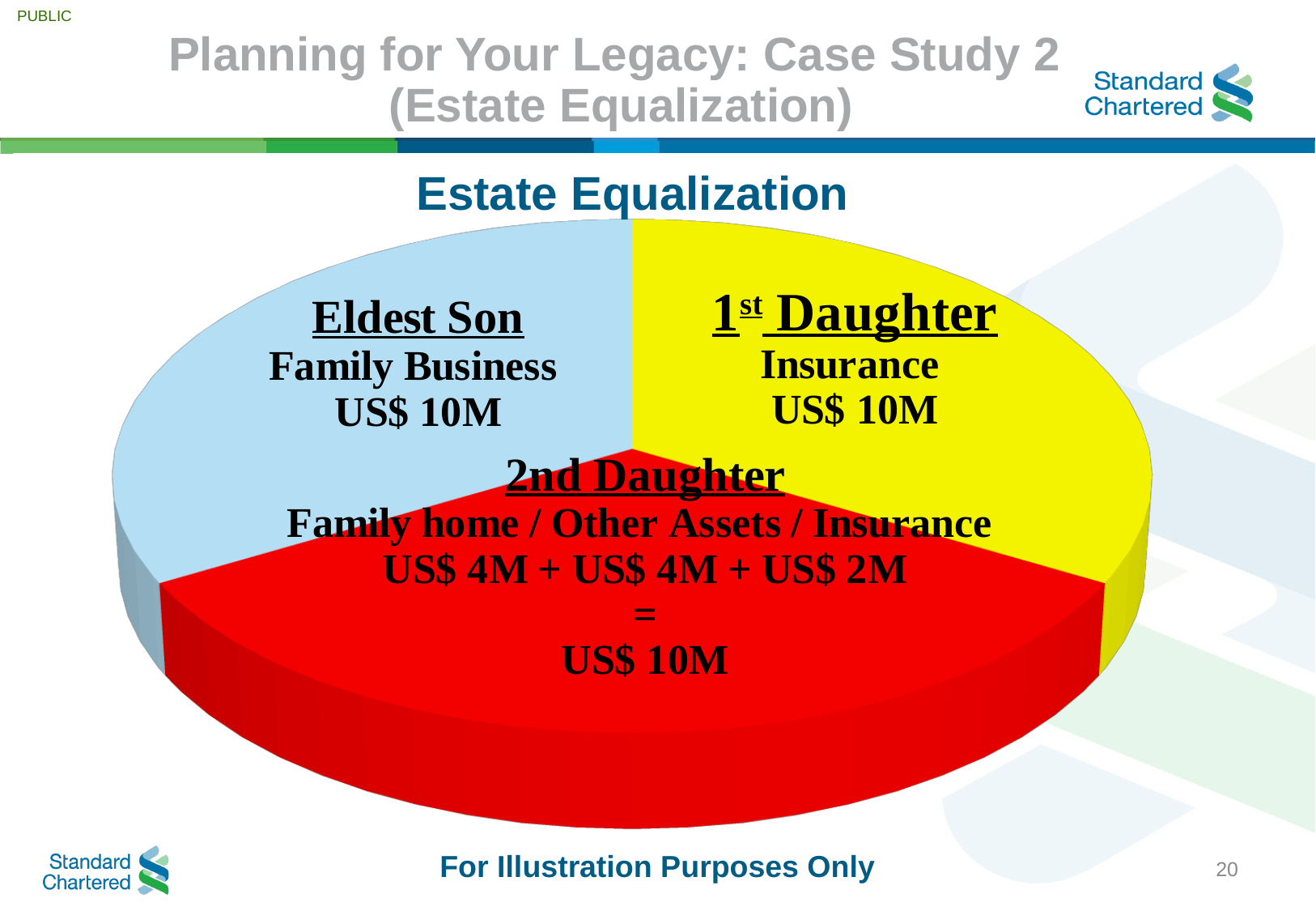
What is the title of the pie chart? Estate Equalization What three amounts make up the 2nd Daughter's US$ 10M share? US$ 4M + US$ 4M + US$ 2M Is the Eldest Son's share larger than, smaller than, or equal to the 1st Daughter's share? Equal What asset does the Eldest Son receive? Family Business What is the value of the Eldest Son's share of the estate? US$ 10M What asset does the 1st Daughter receive? Insurance What is the value of the 1st Daughter's share of the estate? US$ 10M How many slices does the pie chart have? 3 What is the combined value of all three slices of the pie chart? US$ 30M Which colour is the 2nd Daughter's slice of the pie chart? Red What is the total value of the 2nd Daughter's share of the estate? US$ 10M What kind of chart is shown on the slide? Pie chart